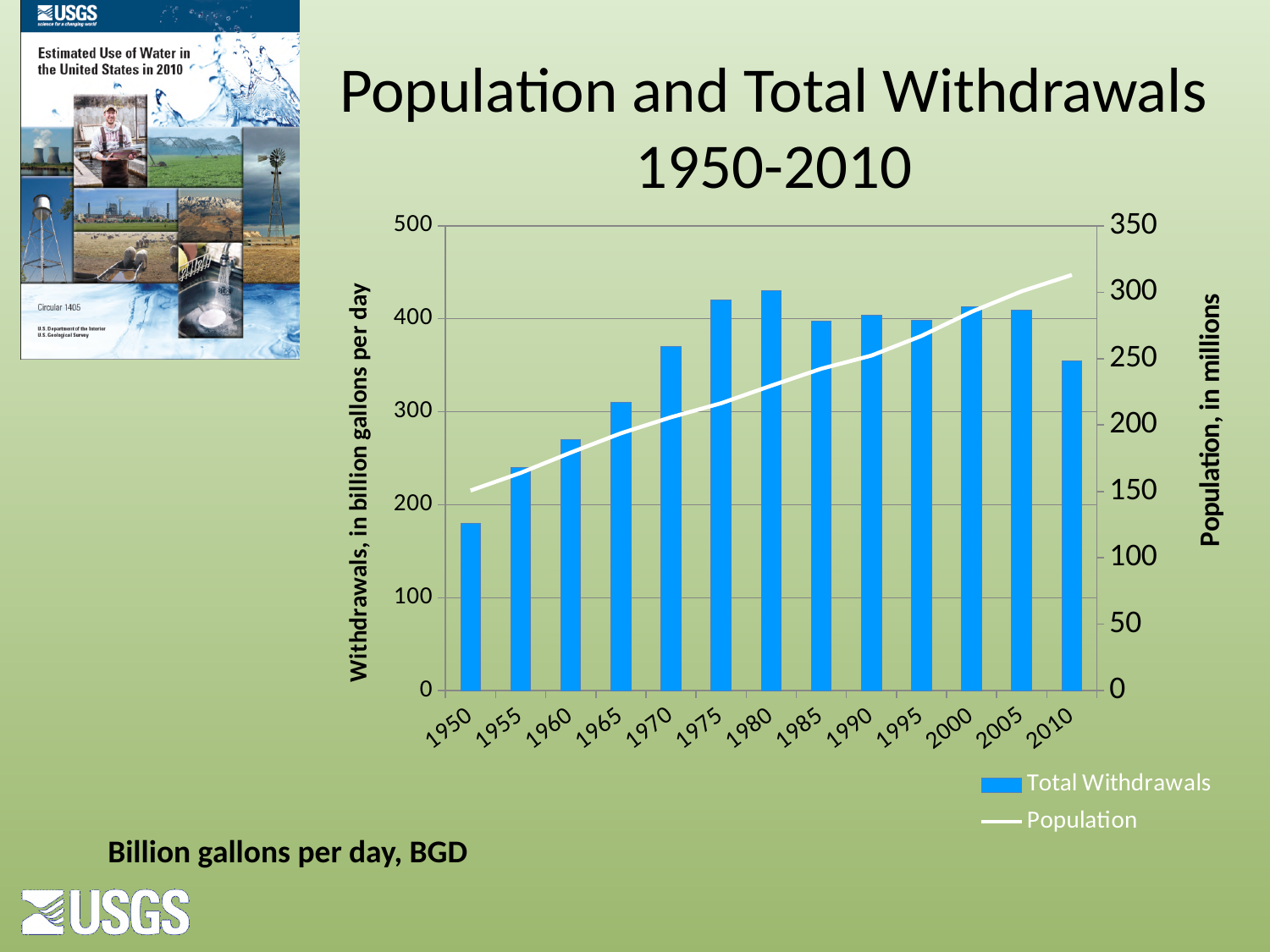
Is the Total Withdrawals value for 2010 greater or less than 400? less Is the Population value for 2010 greater or less than 300 million? greater How many years are shown along the x axis? 13 Which year has the highest Total Withdrawals bar? 1980 Which year has the lowest Total Withdrawals bar? 1950 Does the Population line rise or fall from 1950 to 2010? Rises What kind of chart is shown on the slide? A bar chart combined with a line Which year has larger Total Withdrawals, 1960 or 1970? 1970 How many series does the legend list? 2 What is the label of the left vertical axis? Withdrawals, in billion gallons per day Is the Total Withdrawals value for 1950 greater or less than 200? less